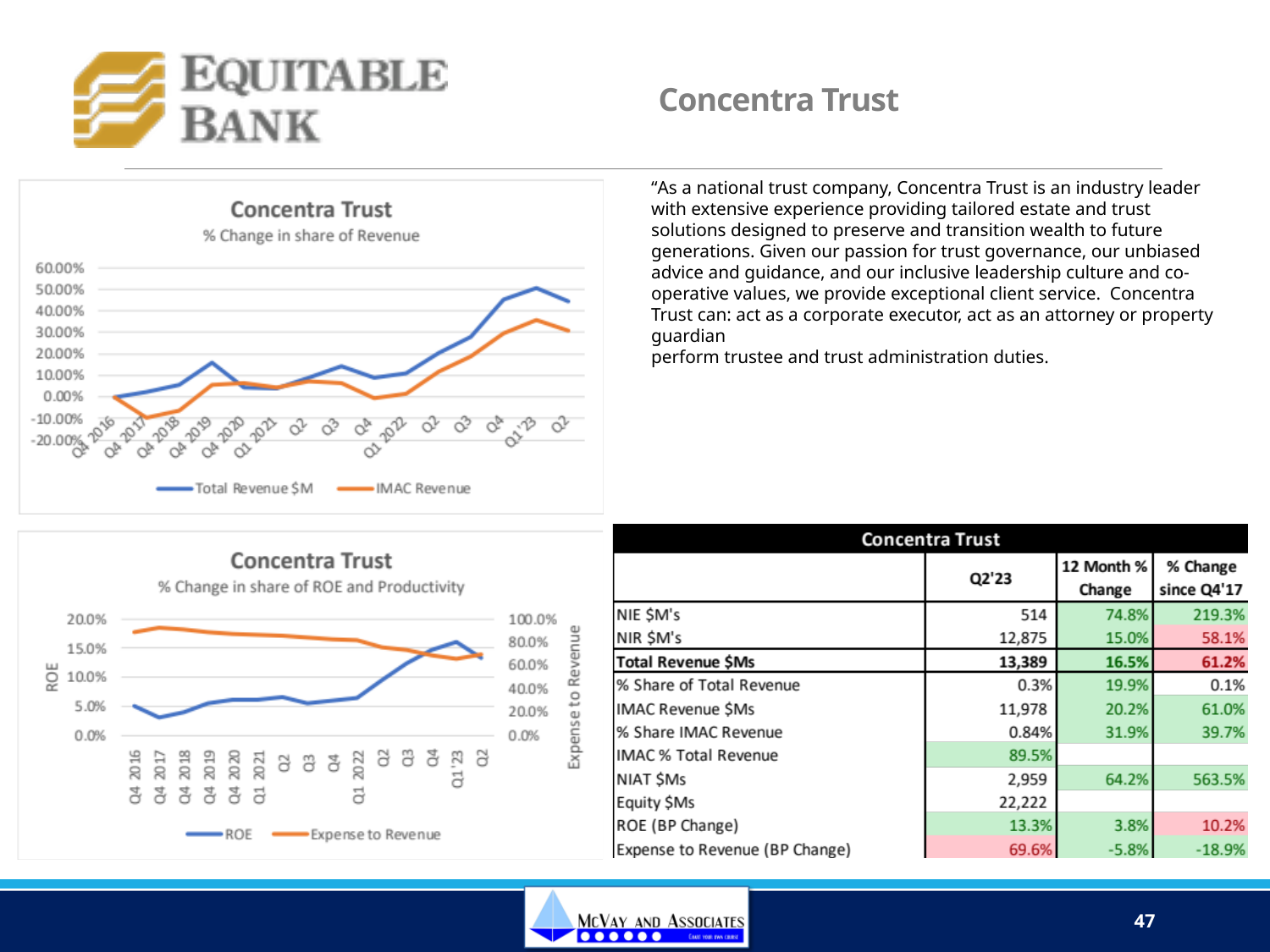
In the top chart (% Change in share of Revenue), does Total Revenue $M generally rise or fall from Q4 2016 to Q2 2023? rise In the top chart (% Change in share of Revenue), at Q1'23, which series is higher: Total Revenue $M or IMAC Revenue? Total Revenue $M In the top chart (% Change in share of Revenue), at which period does Total Revenue $M reach its highest value? Q1'23 What are the two series named in the legend of the top chart (% Change in share of Revenue)? Total Revenue $M and IMAC Revenue In the bottom chart (% Change in share of ROE and Productivity), at which period is ROE at its lowest? Q4 2017 In the bottom chart (% Change in share of ROE and Productivity), does Expense to Revenue generally rise or fall across the periods shown? fall In the top chart (% Change in share of Revenue), at which period is IMAC Revenue at its lowest? Q4 2017 In the top chart (% Change in share of Revenue), is the Total Revenue $M value at Q1'23 greater or less than 40.00%? greater What is the subtitle of the bottom chart? % Change in share of ROE and Productivity What kind of chart is the top chart titled 'Concentra Trust % Change in share of Revenue'? line chart How many series does the legend of the top chart (% Change in share of Revenue) list? 2 In the top chart (% Change in share of Revenue), how many periods are shown on the x axis? 15